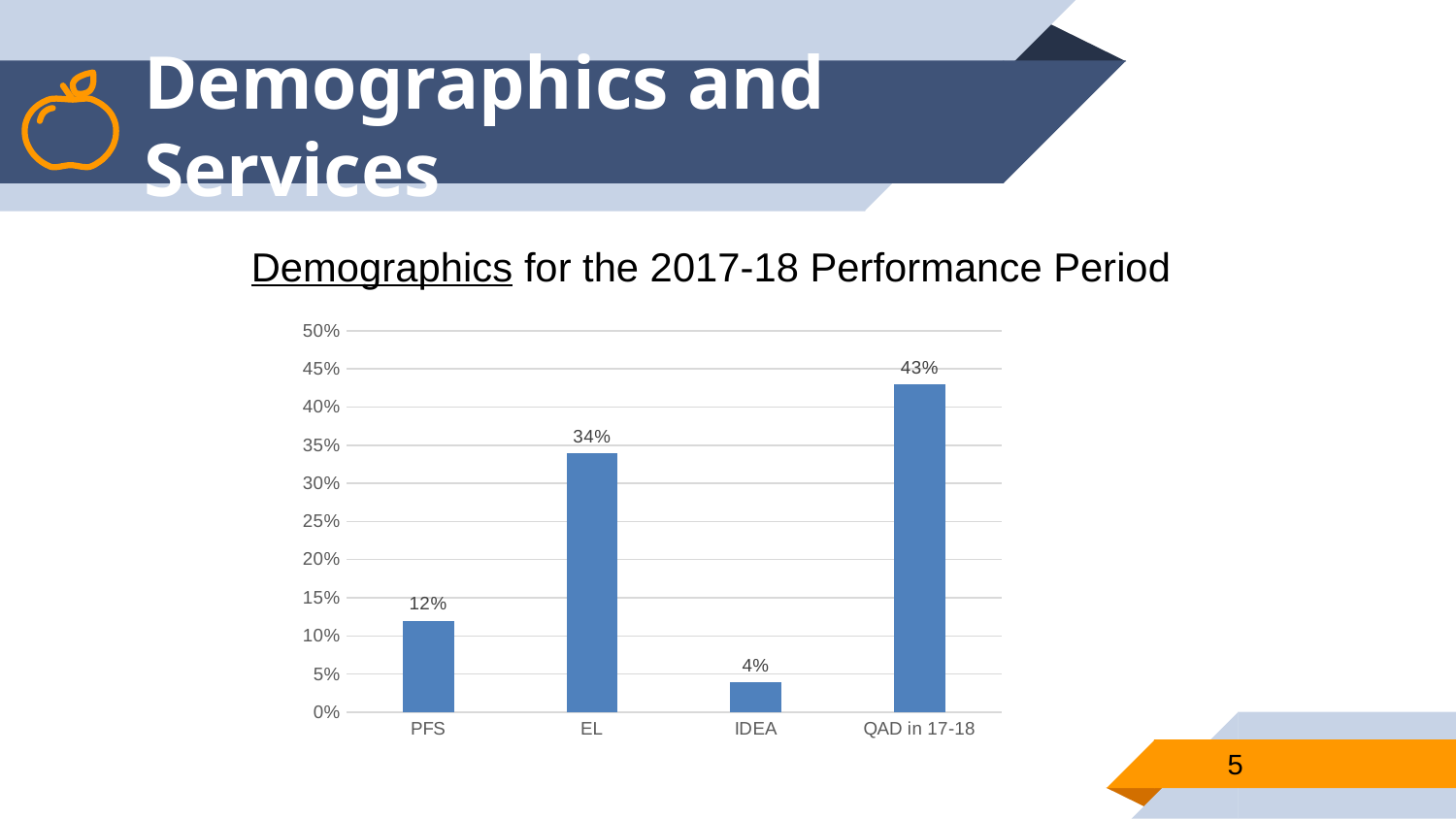
Which is larger, the value for EL or the value for PFS? EL What is the value for EL? 34% Which category has the lowest value? IDEA Which category has the highest value? QAD in 17-18 What is the value for PFS? 12% What is the difference between the values for QAD in 17-18 and EL? 9% What is the difference between the values for PFS and IDEA? 8% What kind of chart is shown on the slide? Bar chart What is the title of the chart? Demographics for the 2017-18 Performance Period How many categories are shown on the x axis? 4 What is the value for QAD in 17-18? 43% What is the value for IDEA? 4%